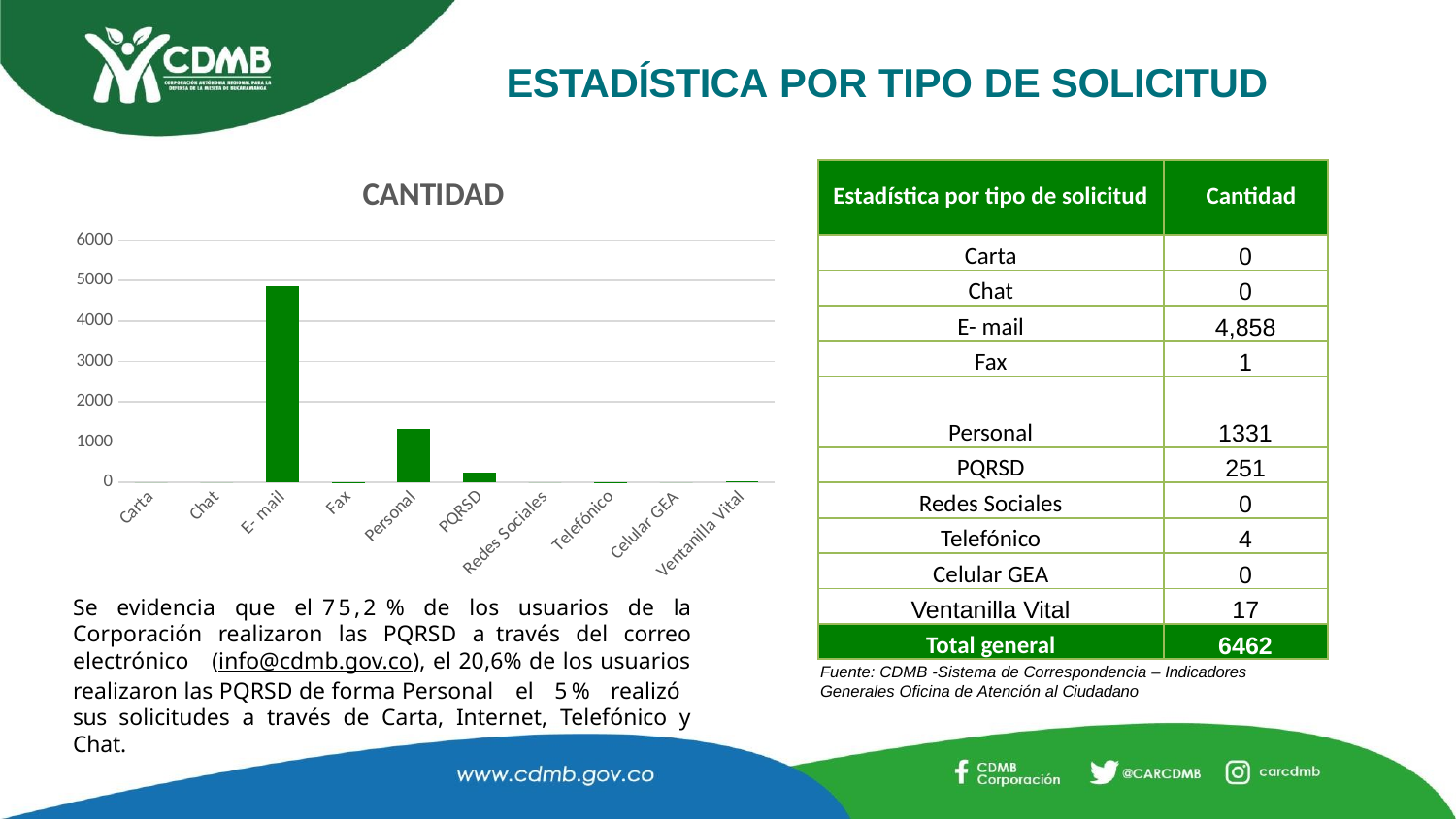
What is the difference between the values for E- mail and Personal? 3527 What is the value for Personal? 1331 What is the value for E- mail? 4,858 Is the value for E- mail greater or less than 4000? greater How many categories are shown on the x axis of the chart? 10 What is the value for Ventanilla Vital? 17 What is the title of the chart? CANTIDAD Which category has the highest value in the chart? E- mail Is the value for PQRSD greater or less than 1000? less Is the value for Personal greater or less than 1000? greater What type of chart is shown on the slide? bar chart Which is larger, the value for Personal or the value for PQRSD? Personal